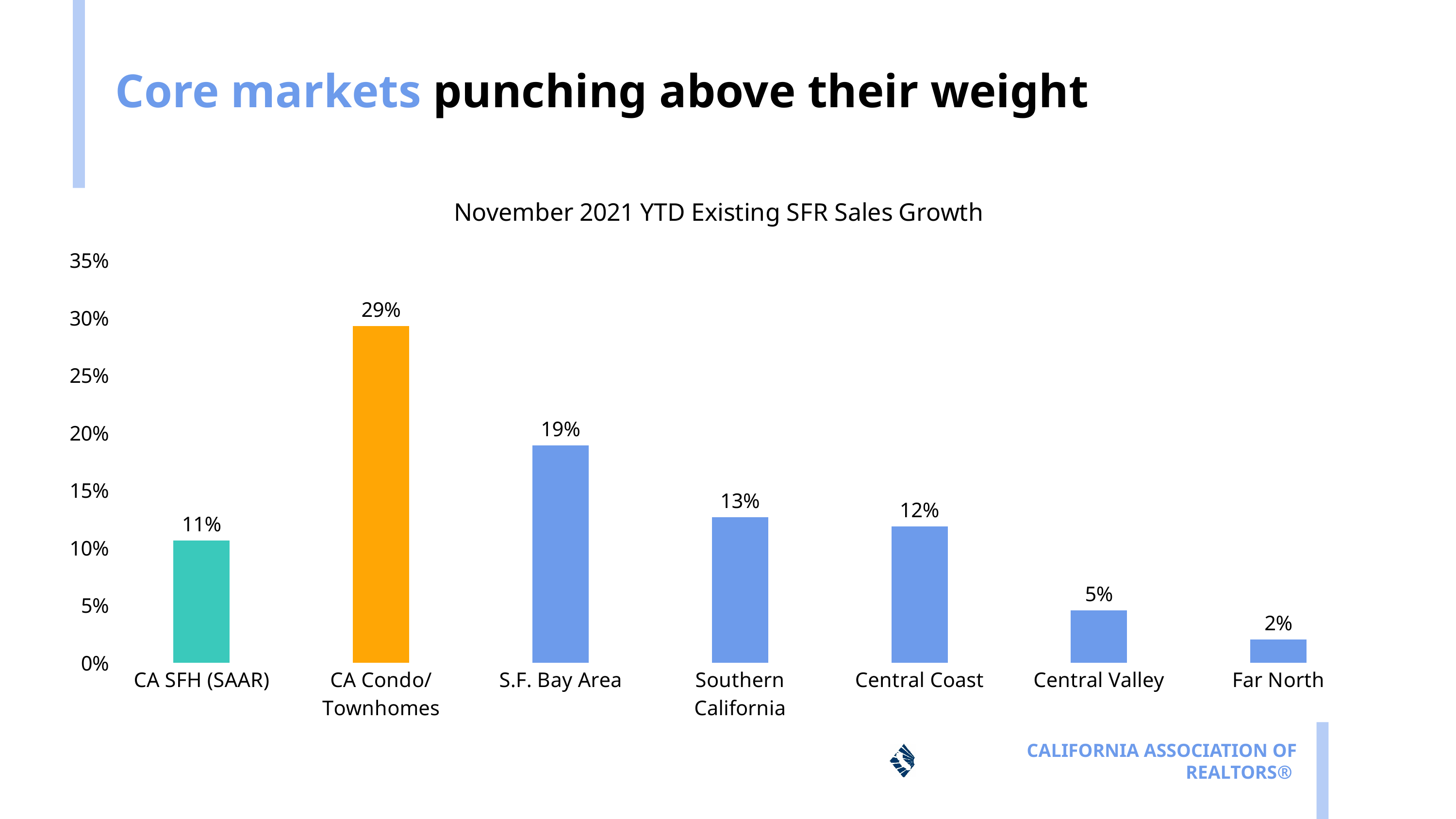
What kind of chart is shown on the slide? Bar chart How many categories are shown on the chart? 7 Which category has the lowest value? Far North Which is larger, the value for Southern California or the value for Central Valley? Southern California Which category has the highest value? CA Condo/Townhomes What is the value for Central Valley? 5% What is the value for Far North? 2% What is the difference between the values for CA Condo/Townhomes and CA SFH (SAAR)? 18% What is the title of the chart? November 2021 YTD Existing SFR Sales Growth What is the value for S.F. Bay Area? 19% What is the value for CA Condo/Townhomes? 29% What is the difference between the values for S.F. Bay Area and Southern California? 6%